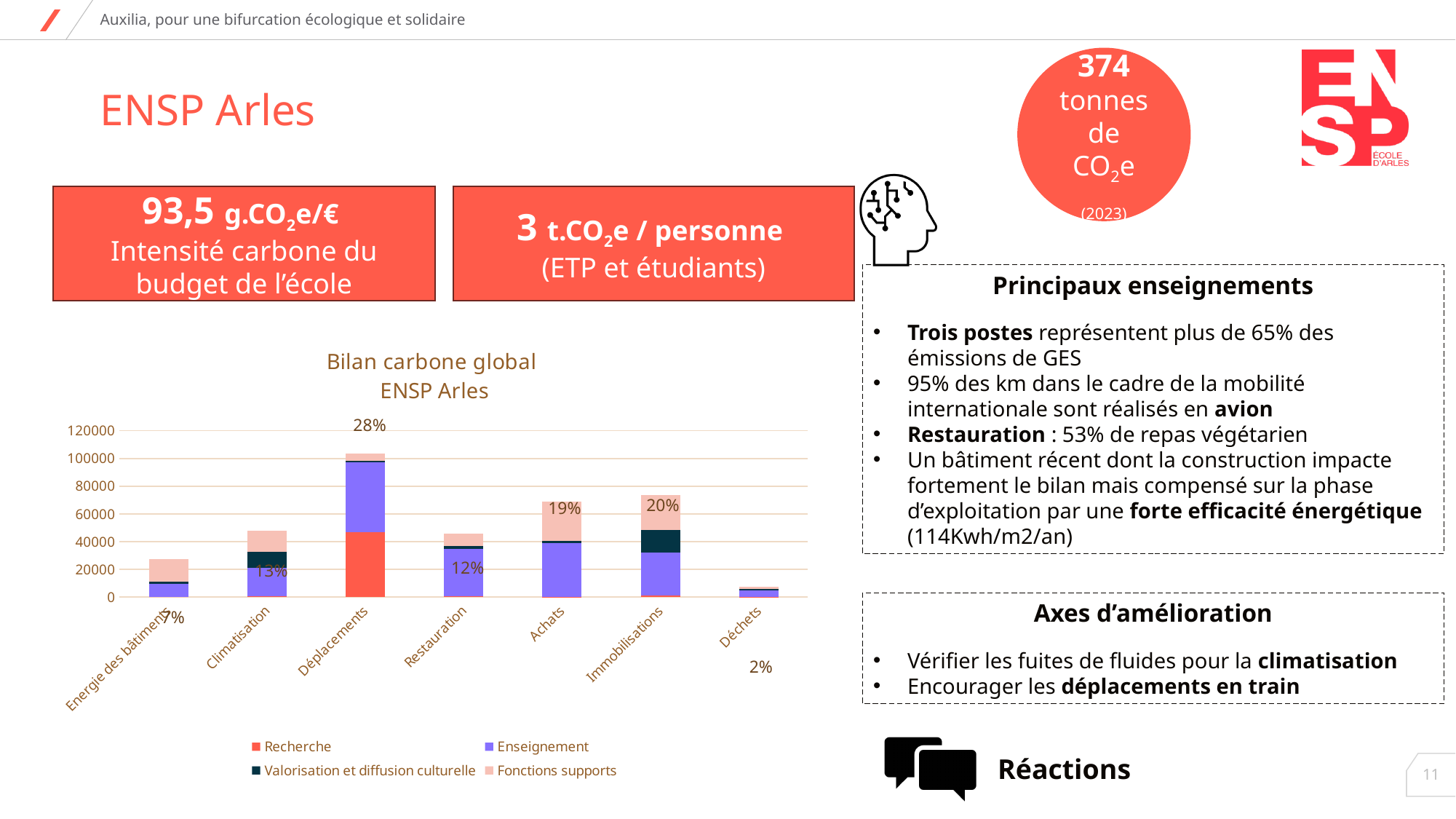
In the 'Bilan carbone global ENSP Arles' chart, is the total for Déplacements greater or less than 100000? greater In the 'Bilan carbone global ENSP Arles' chart, what is the difference in percentage points between the labels for Déplacements (28%) and Restauration (12%)? 16 percentage points How many series does the legend of the 'Bilan carbone global ENSP Arles' chart list? 4 Which category has the highest total in the 'Bilan carbone global ENSP Arles' chart? Déplacements Which category has the lowest total in the 'Bilan carbone global ENSP Arles' chart? Déchets In the 'Bilan carbone global ENSP Arles' chart, is the total for Déchets greater or less than 20000? less What kind of chart is shown under the title 'Bilan carbone global ENSP Arles'? stacked bar chart What percentage label is shown for Déplacements in the 'Bilan carbone global ENSP Arles' chart? 28% What percentage label is shown for Immobilisations in the 'Bilan carbone global ENSP Arles' chart? 20% In the 'Bilan carbone global ENSP Arles' chart, which has the larger total: Déplacements or Achats? Déplacements How many categories are shown on the x axis of the 'Bilan carbone global ENSP Arles' chart? 7 What percentage label is shown for Climatisation in the 'Bilan carbone global ENSP Arles' chart? 13%